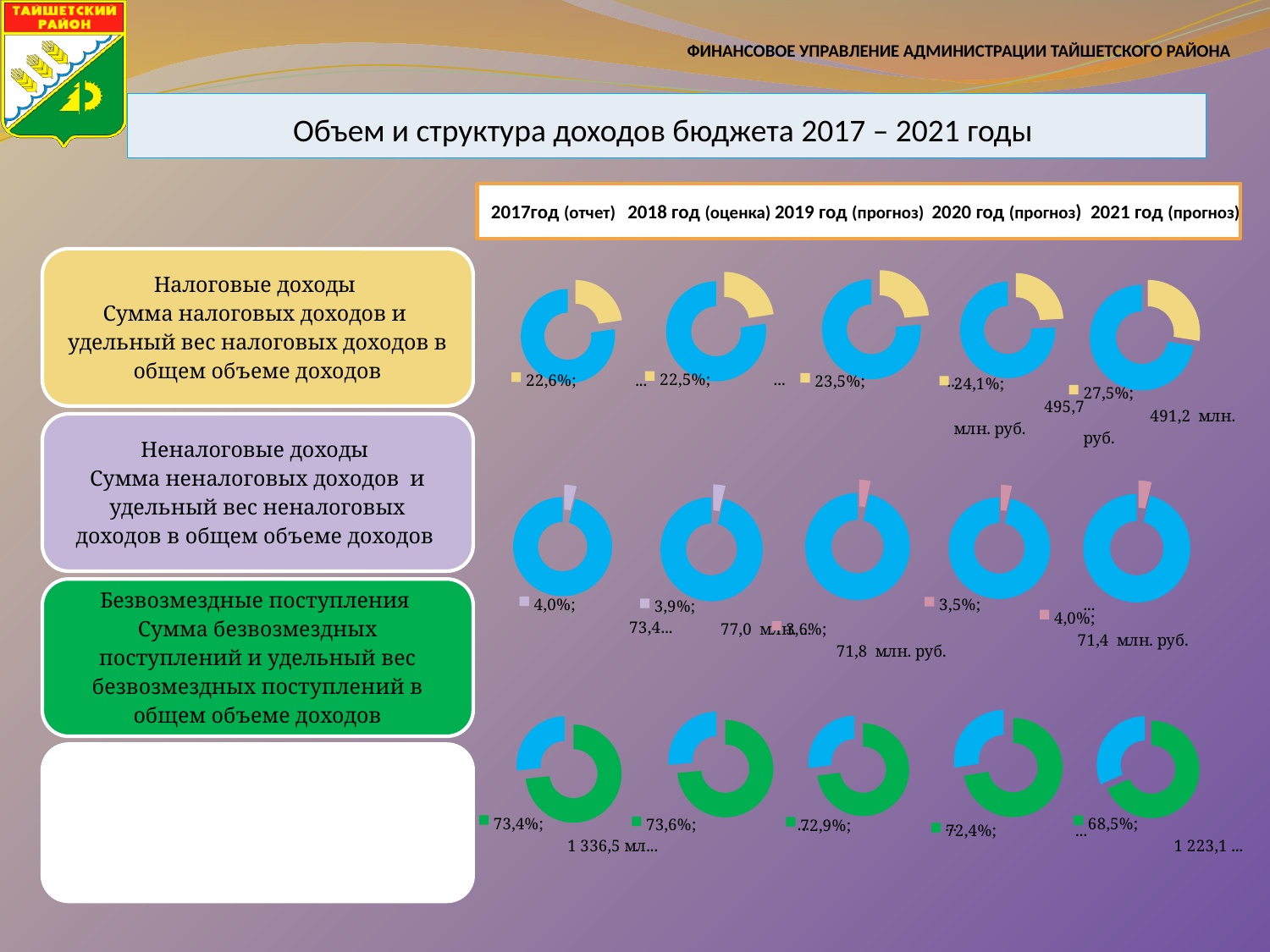
How many donut charts are shown in each row on the slide? 5 In the middle row of donut charts (non-tax revenues), what share is shown for 2018 (estimate)? 3,9% In the top row of donut charts (tax revenues), what is the difference in percentage points between the 2021 share and the 2017 share? 4,9 In the bottom row of donut charts (gratuitous receipts), which year has the highest share? 2018 год (оценка) What type of chart is used to show the revenue structure on this slide? Donut (pie) chart In the top row of donut charts (tax revenues), which year has the highest share of tax revenues? 2021 год (прогноз) In the top row of donut charts (tax revenues), which year has the lowest share of tax revenues? 2018 год (оценка) In the middle row of donut charts (non-tax revenues), what share is shown for 2020 (forecast)? 3,5% In the top row of donut charts (tax revenues), what share is shown for 2017 (report)? 22,6% In the bottom row of donut charts (gratuitous receipts), is the share for 2019 (forecast) larger or smaller than the share for 2021 (forecast)? larger In the bottom row of donut charts (gratuitous receipts), what share is shown for 2021 (forecast)? 68,5% In the top row of donut charts (tax revenues), what share is shown for 2021 (forecast)? 27,5%